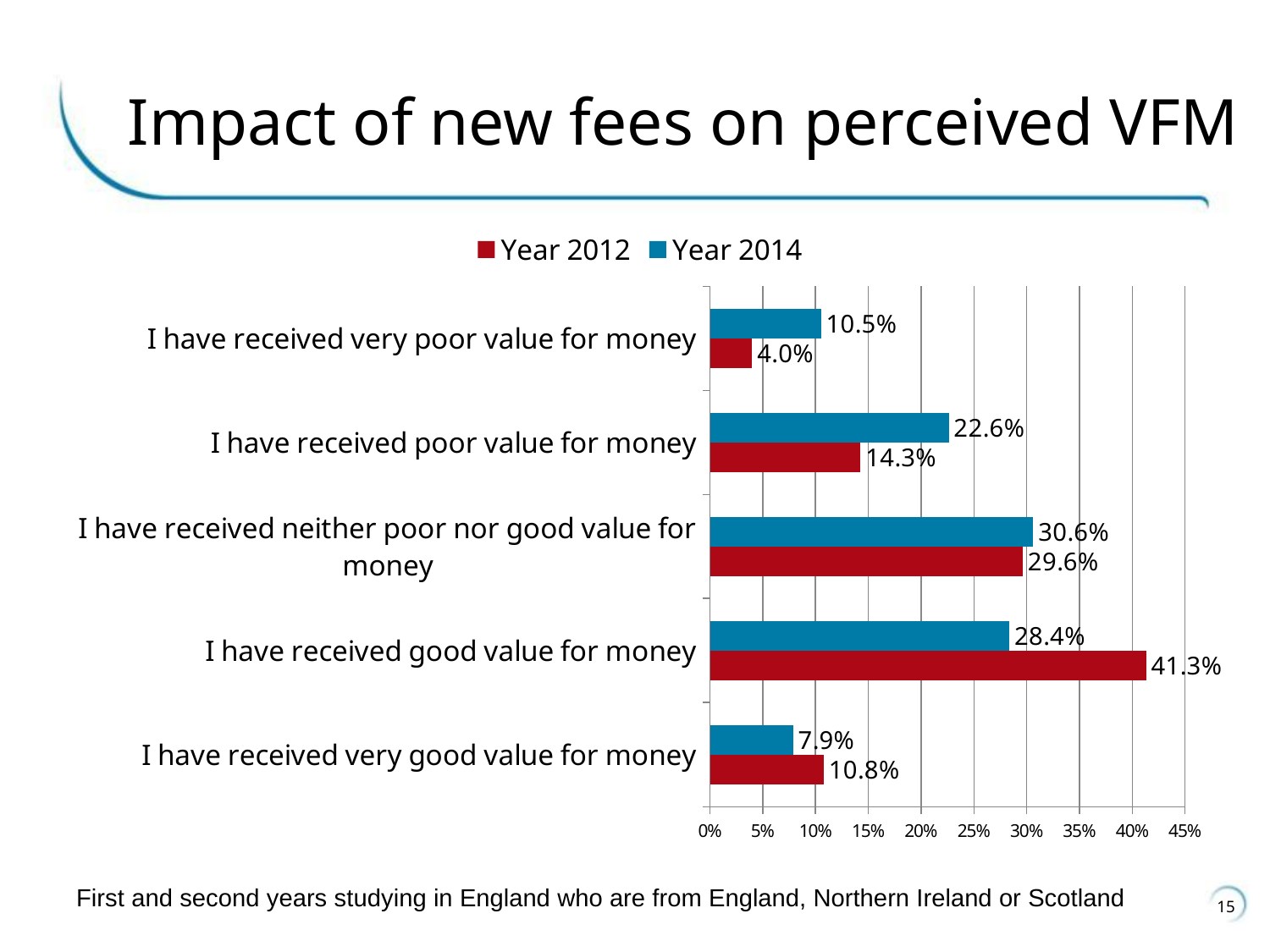
What is the Year 2012 value for "I have received poor value for money"? 14.3% What is the difference between the Year 2012 and Year 2014 values for "I have received good value for money"? 12.9% Which category has the lowest Year 2014 value? I have received very good value for money What kind of chart is shown on the slide? Bar chart For "I have received poor value for money", which year has the larger value, Year 2012 or Year 2014? Year 2014 Which colour represents Year 2014 in the chart? Blue Which category has the highest Year 2012 value? I have received good value for money What is the Year 2014 value for "I have received very poor value for money"? 10.5% What is the Year 2014 value for "I have received very good value for money"? 7.9% What is the Year 2012 value for "I have received good value for money"? 41.3% How many categories are shown on the chart? 5 How many series does the legend list? 2